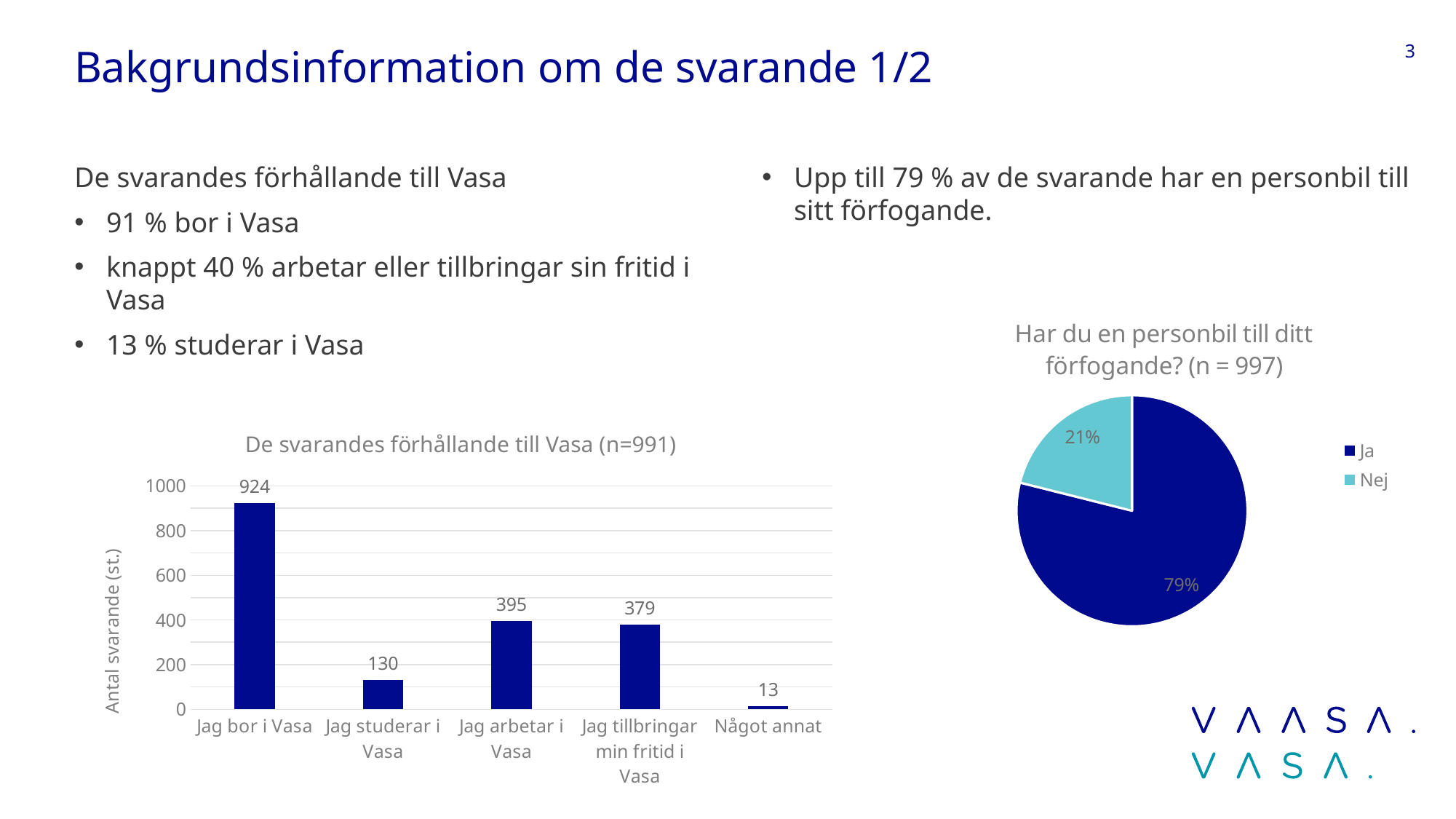
How many categories are shown in the chart 'De svarandes förhållande till Vasa (n=991)'? 5 In the chart 'De svarandes förhållande till Vasa (n=991)', what is the value for 'Något annat'? 13 In the chart 'De svarandes förhållande till Vasa (n=991)', which category has the highest value? Jag bor i Vasa In the pie chart 'Har du en personbil till ditt förfogande? (n = 997)', what share of respondents answered 'Ja'? 79% What is the y-axis label of the chart 'De svarandes förhållande till Vasa (n=991)'? Antal svarande (st.) In the chart 'De svarandes förhållande till Vasa (n=991)', what is the difference between 'Jag arbetar i Vasa' and 'Jag tillbringar min fritid i Vasa'? 16 In the chart 'De svarandes förhållande till Vasa (n=991)', what is the value for 'Jag studerar i Vasa'? 130 In the chart 'De svarandes förhållande till Vasa (n=991)', which is larger: 'Jag studerar i Vasa' or 'Jag arbetar i Vasa'? Jag arbetar i Vasa In the pie chart 'Har du en personbil till ditt förfogande? (n = 997)', what share of respondents answered 'Nej'? 21% What kind of chart is 'De svarandes förhållande till Vasa (n=991)'? Bar chart In the chart 'De svarandes förhållande till Vasa (n=991)', what is the value for 'Jag bor i Vasa'? 924 In the chart 'De svarandes förhållande till Vasa (n=991)', which category has the lowest value? Något annat